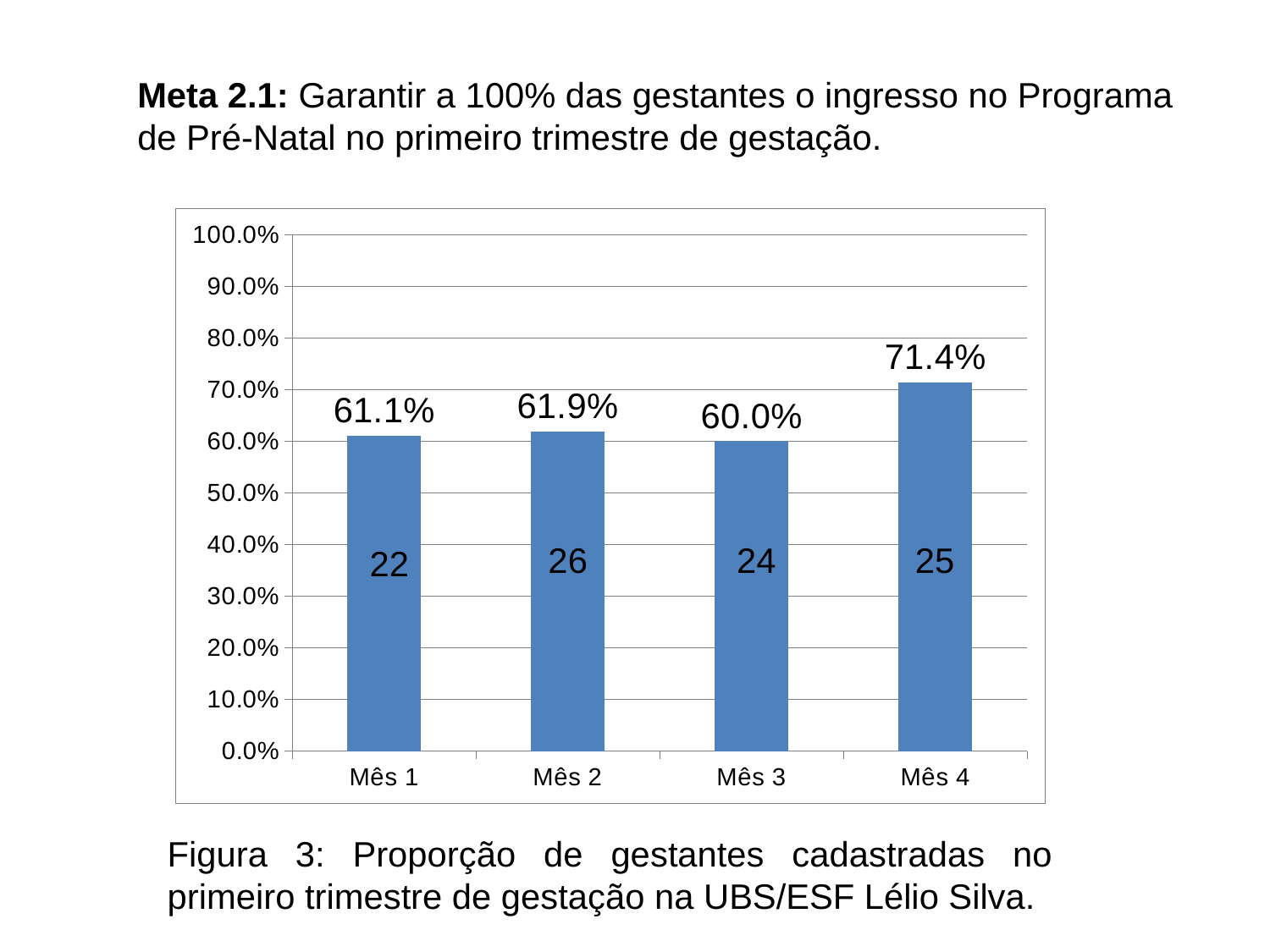
What is the figure caption below the chart? Figura 3: Proporção de gestantes cadastradas no primeiro trimestre de gestação na UBS/ESF Lélio Silva. Which month has the lowest proportion? Mês 3 Which is larger, the value for Mês 2 or the value for Mês 1? Mês 2 What is the value for Mês 1? 61.1% Is the value for Mês 4 greater or less than 70.0%? greater Which month has the highest proportion? Mês 4 What kind of chart is shown on the slide? bar chart What is the highest value shown on the y axis? 100.0% How many months are shown on the x axis? 4 What is the value for Mês 4? 71.4% What is the difference between the values for Mês 4 and Mês 3? 11.4% What number is printed inside the bar for Mês 2? 26